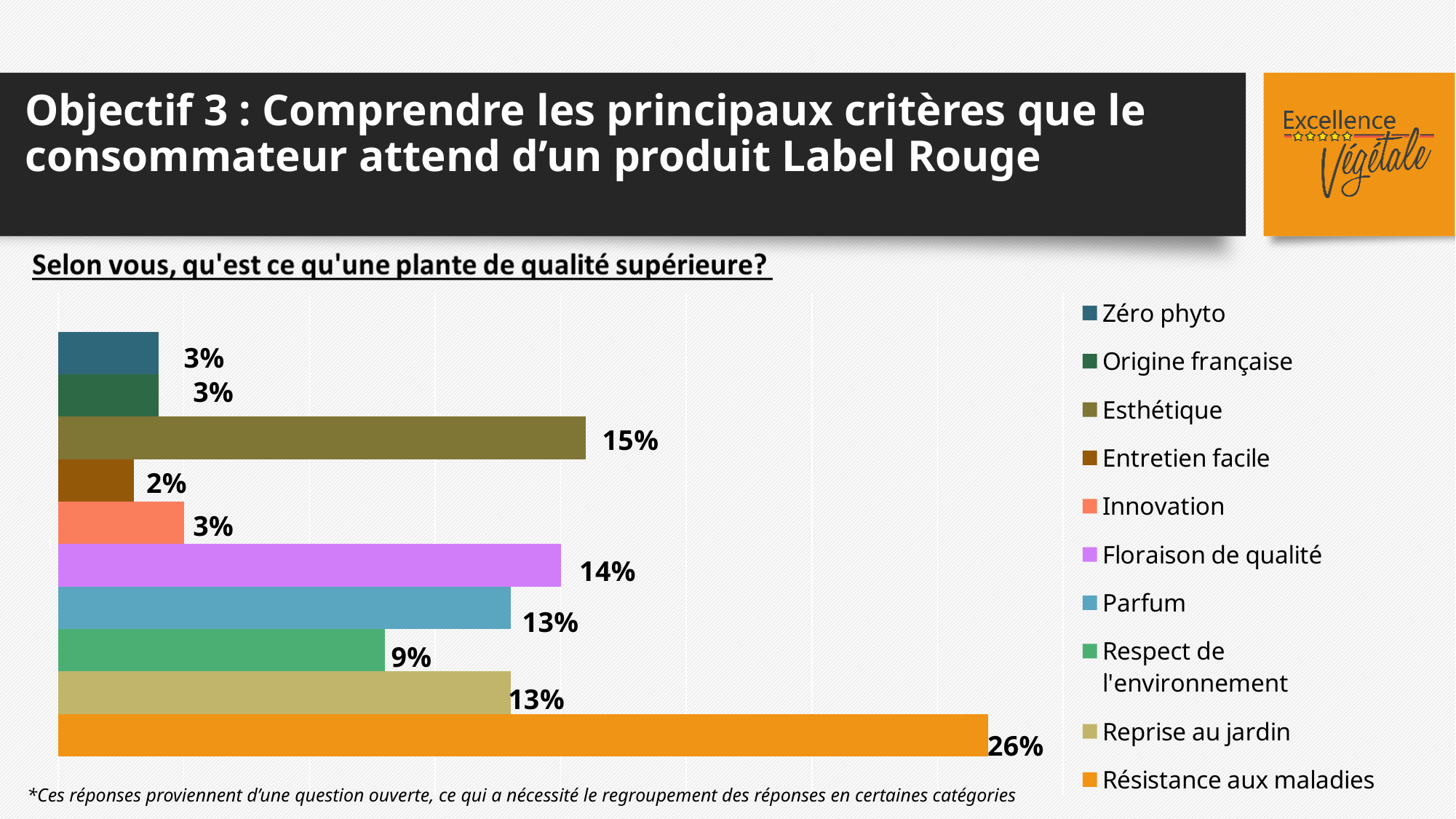
Which category has the lowest value? Entretien facile What is the value for Esthétique? 15% How many categories are plotted in the chart? 10 What is the difference between the values for Résistance aux maladies and Esthétique? 11% What is the value for Résistance aux maladies? 26% What colour is the bar for Résistance aux maladies? orange What type of chart is shown on the slide? bar chart What is the value for Respect de l'environnement? 9% Which category has the highest value? Résistance aux maladies What is the value for Floraison de qualité? 14% How many entries does the legend list? 10 Which is larger, the value for Floraison de qualité or the value for Parfum? Floraison de qualité